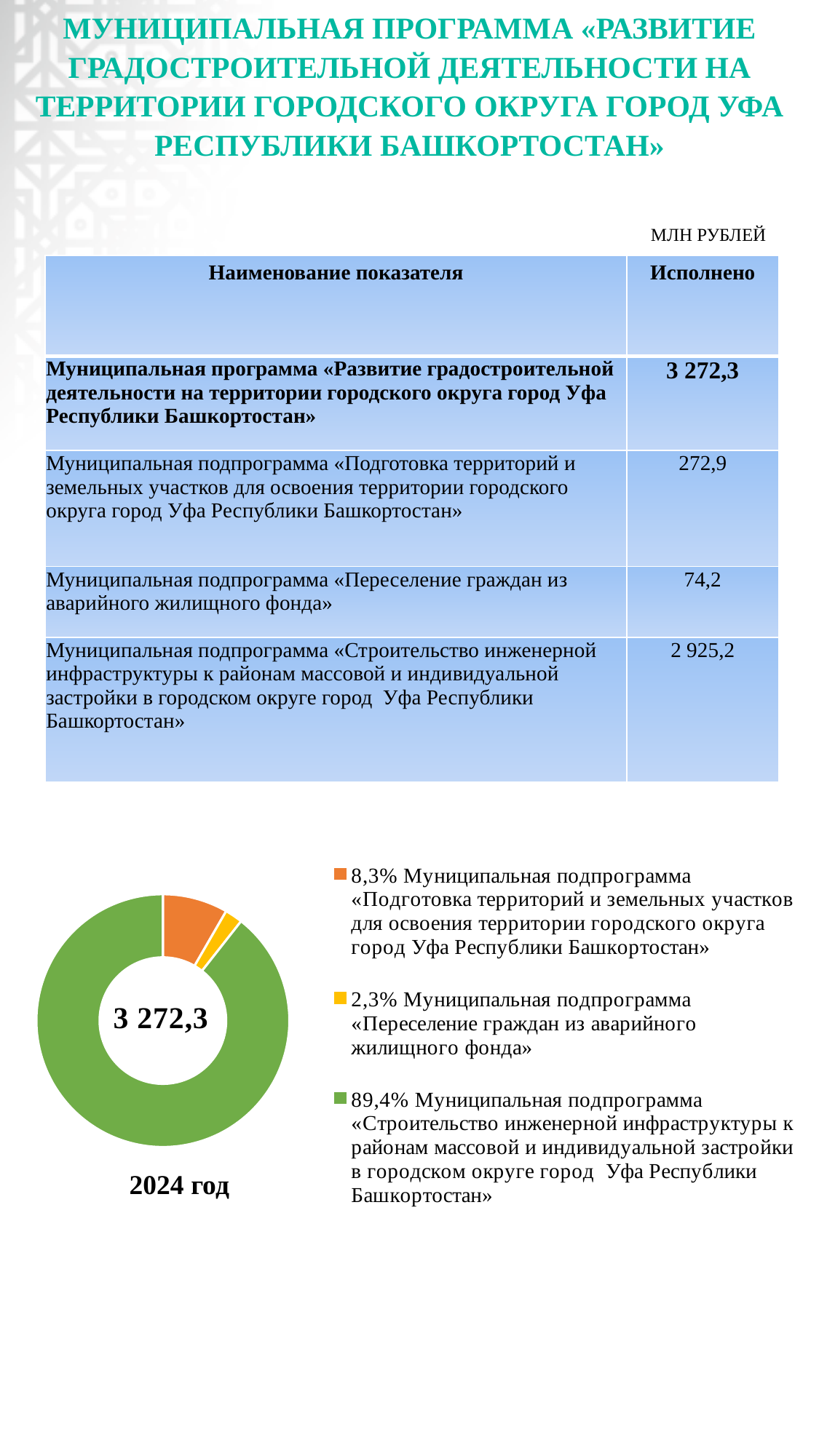
In the doughnut chart, which slice is larger: «Подготовка территорий и земельных участков...» or «Переселение граждан из аварийного жилищного фонда»? «Подготовка территорий и земельных участков...» What value is printed in the centre of the doughnut chart? 3 272,3 What share of the doughnut chart does the subprogram «Переселение граждан из аварийного жилищного фонда» have? 2,3% What is the difference in percentage points between the 8,3% slice and the 2,3% slice in the doughnut chart? 6 percentage points What kind of chart is shown at the bottom of the slide? Doughnut (pie) chart Which subprogram has the largest slice in the doughnut chart? «Строительство инженерной инфраструктуры к районам массовой и индивидуальной застройки в городском округе город Уфа Республики Башкортостан» How many entries does the legend of the doughnut chart list? 3 What colour is the slice for the subprogram «Переселение граждан из аварийного жилищного фонда» in the doughnut chart? Yellow What share of the doughnut chart does the subprogram «Строительство инженерной инфраструктуры к районам массовой и индивидуальной застройки в городском округе город Уфа Республики Башкортостан» have? 89,4% Which subprogram has the smallest slice in the doughnut chart? «Переселение граждан из аварийного жилищного фонда» How many slices does the doughnut chart have? 3 What share of the doughnut chart does the subprogram «Подготовка территорий и земельных участков для освоения территории городского округа город Уфа Республики Башкортостан» have? 8,3%